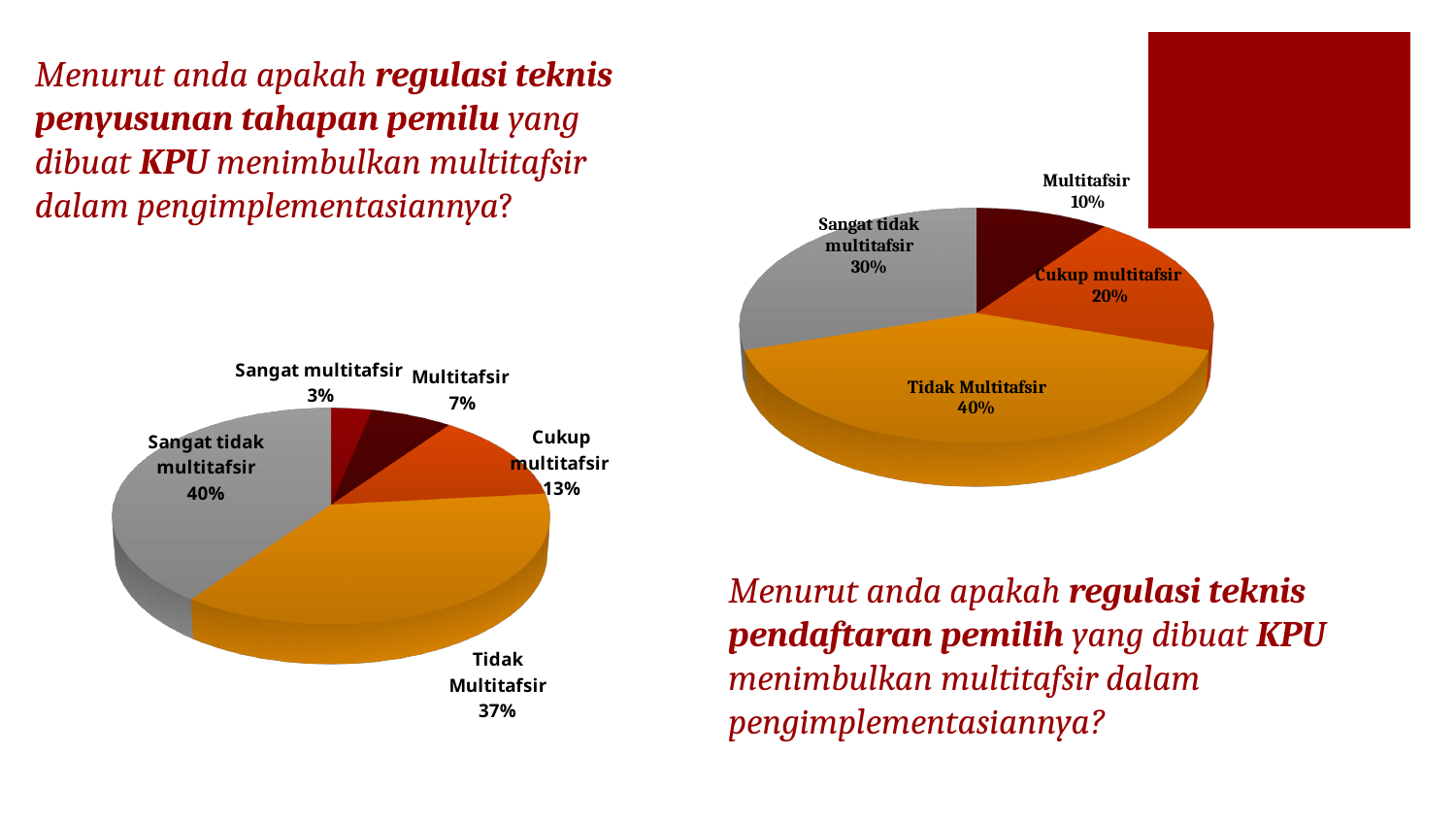
What type of chart is shown on the right of the slide? Pie chart In the pie chart on the left, what is the difference between the shares of Tidak Multitafsir and Multitafsir? 30% In the pie chart on the right, which category has the smallest share? Multitafsir In the pie chart on the right, what percentage is labelled for Multitafsir? 10% In the pie chart on the right, which is larger: Sangat tidak multitafsir or Cukup multitafsir? Sangat tidak multitafsir In the pie chart on the left, what percentage is labelled for Sangat tidak multitafsir? 40% In the pie chart on the left, which category has the largest share? Sangat tidak multitafsir In the pie chart on the left, which category has the smallest share? Sangat multitafsir In the pie chart on the left, what percentage is labelled for Cukup multitafsir? 13% In the pie chart on the right, what percentage is labelled for Tidak Multitafsir? 40% How many slices does the pie chart on the left have? 5 How many slices does the pie chart on the right have? 4